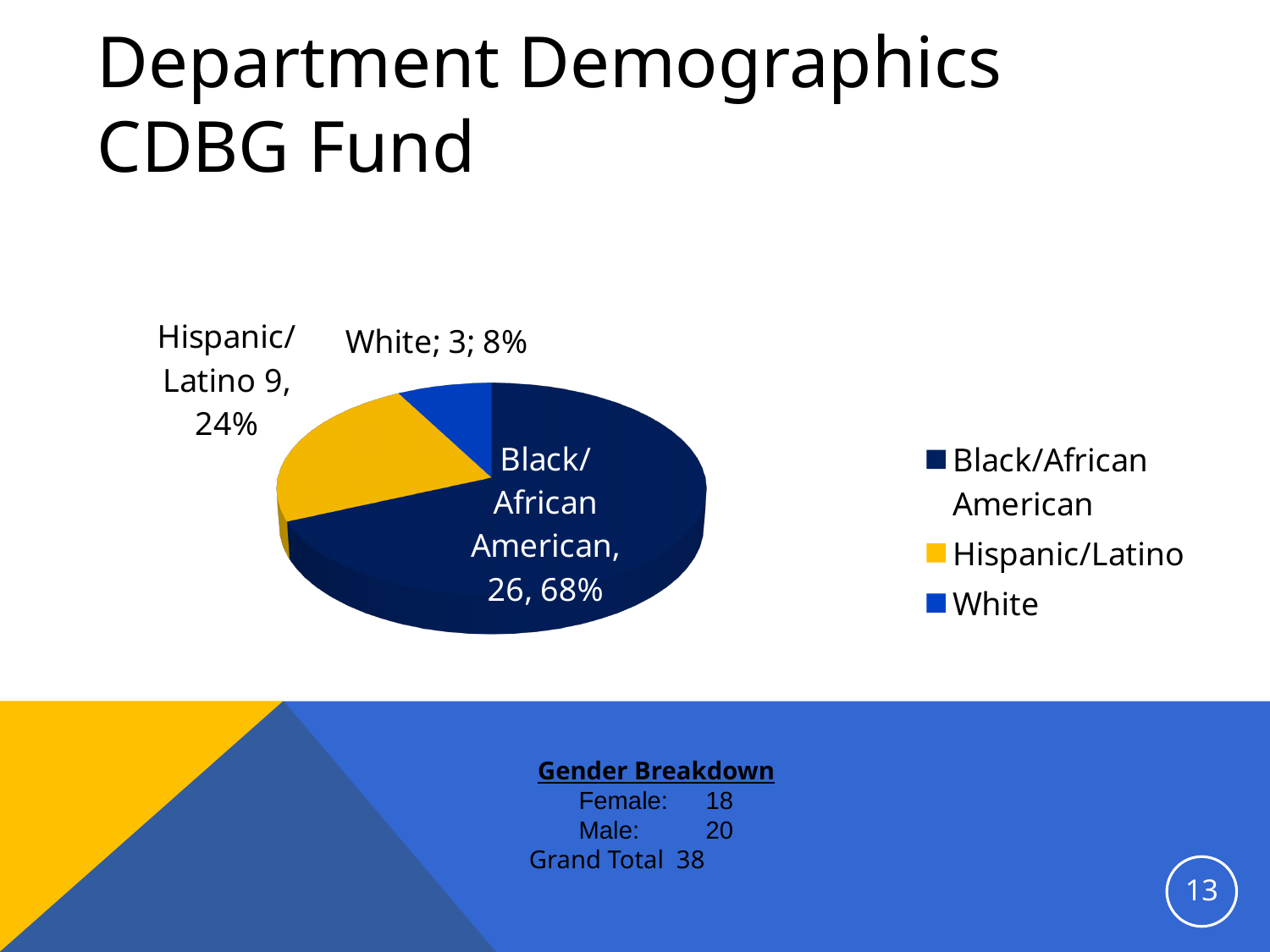
What is the value shown for White in the pie chart? 3 What type of chart is shown on the slide? pie chart What colour is used for the Hispanic/Latino slice in the pie chart? yellow What share of the pie does the White slice represent? 8% Which category has the smallest slice of the pie? White How many categories does the pie chart show? 3 What is the difference between the Black/African American count and the Hispanic/Latino count? 17 What is the total of all the values shown in the pie chart? 38 How many employees are Black/African American according to the pie chart? 26 What percentage of the pie does Hispanic/Latino represent? 24% Which category has the largest slice of the pie? Black/African American Which is larger, the Hispanic/Latino slice or the White slice? Hispanic/Latino